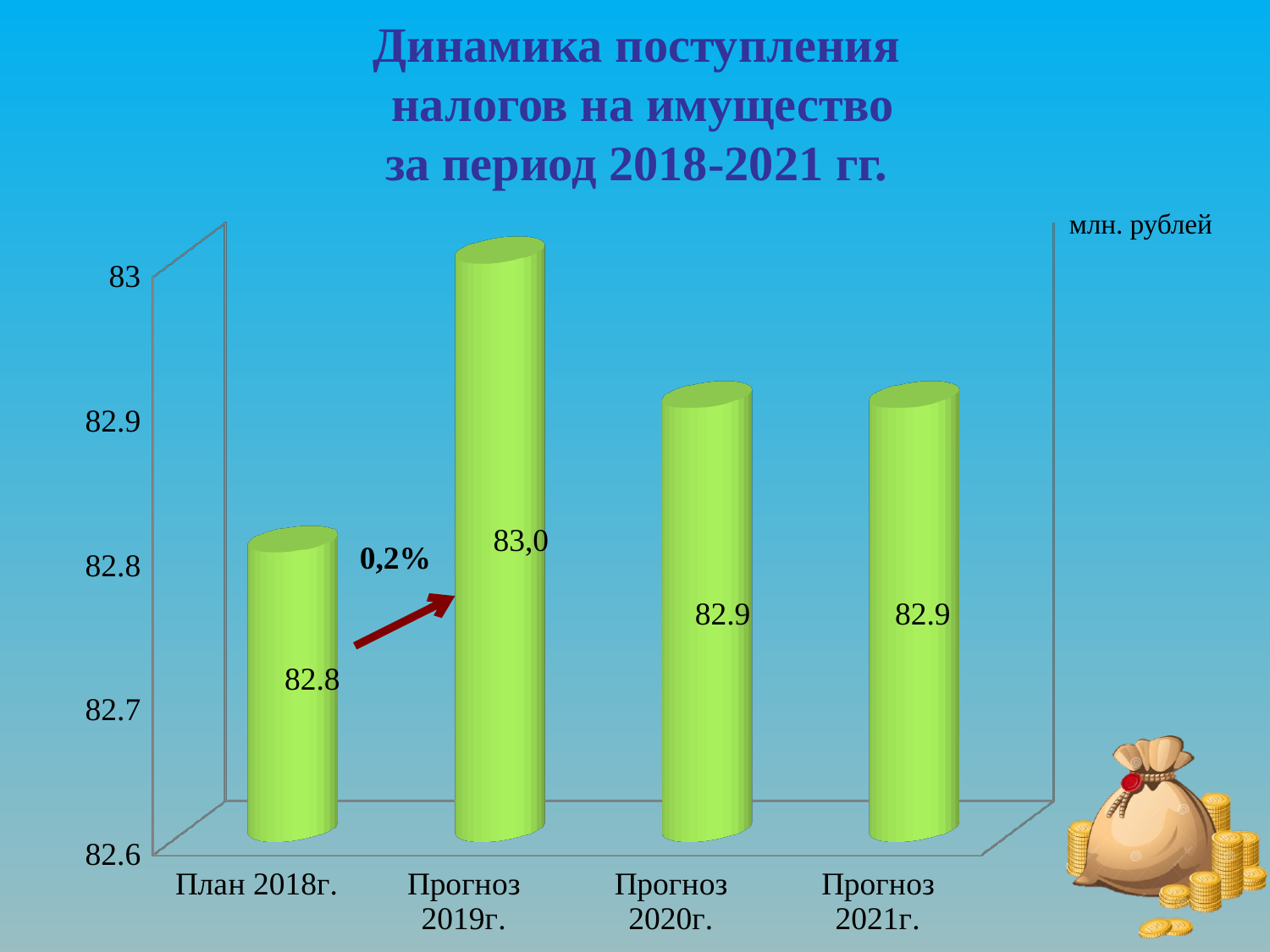
What is the value for Прогноз 2020г.? 82.9 What is the difference between the values for Прогноз 2019г. and План 2018г.? 0.2 Is the value for План 2018г. greater or less than 82.9? less Which is larger, the value for План 2018г. or the value for Прогноз 2020г.? Прогноз 2020г. What is the value for Прогноз 2021г.? 82.9 What kind of chart is shown on the slide? bar chart What unit label is shown at the top right of the chart? млн. рублей What is the value for Прогноз 2019г.? 83,0 What is the value for План 2018г.? 82.8 How many categories are shown on the x axis? 4 Which category has the lowest value? План 2018г. Which category has the highest value? Прогноз 2019г.